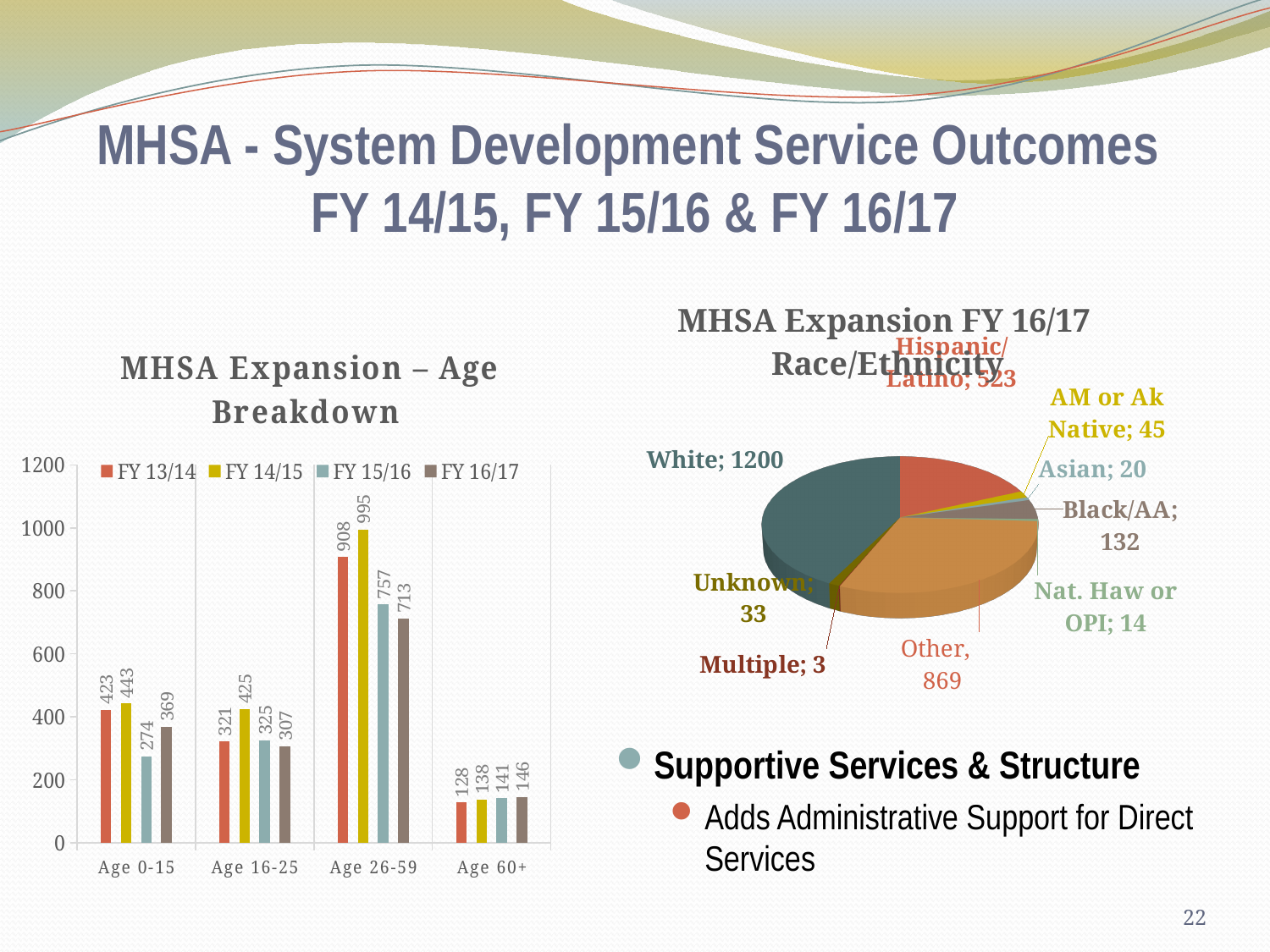
In the MHSA Expansion FY 16/17 Race/Ethnicity chart, what is the value for Black/AA? 132 In the MHSA Expansion – Age Breakdown chart, how many series does the legend list? 4 In the MHSA Expansion – Age Breakdown chart, which age group has the lowest value in FY 13/14? Age 60+ In the MHSA Expansion – Age Breakdown chart, do the values for Age 60+ rise or fall from FY 13/14 to FY 16/17? rise In the MHSA Expansion FY 16/17 Race/Ethnicity chart, which category has the largest slice? White In the MHSA Expansion – Age Breakdown chart, what is the value for Age 0-15 in FY 15/16? 274 In the MHSA Expansion – Age Breakdown chart, what is the difference between the FY 14/15 and FY 16/17 values for Age 26-59? 282 What kind of chart is the MHSA Expansion FY 16/17 Race/Ethnicity chart? pie chart In the MHSA Expansion FY 16/17 Race/Ethnicity chart, how many categories are shown? 9 In the MHSA Expansion – Age Breakdown chart, what is the value for Age 26-59 in FY 14/15? 995 In the MHSA Expansion – Age Breakdown chart, which is larger for Age 16-25: FY 13/14 or FY 14/15? FY 14/15 In the MHSA Expansion – Age Breakdown chart, which age group has the highest value in FY 16/17? Age 26-59